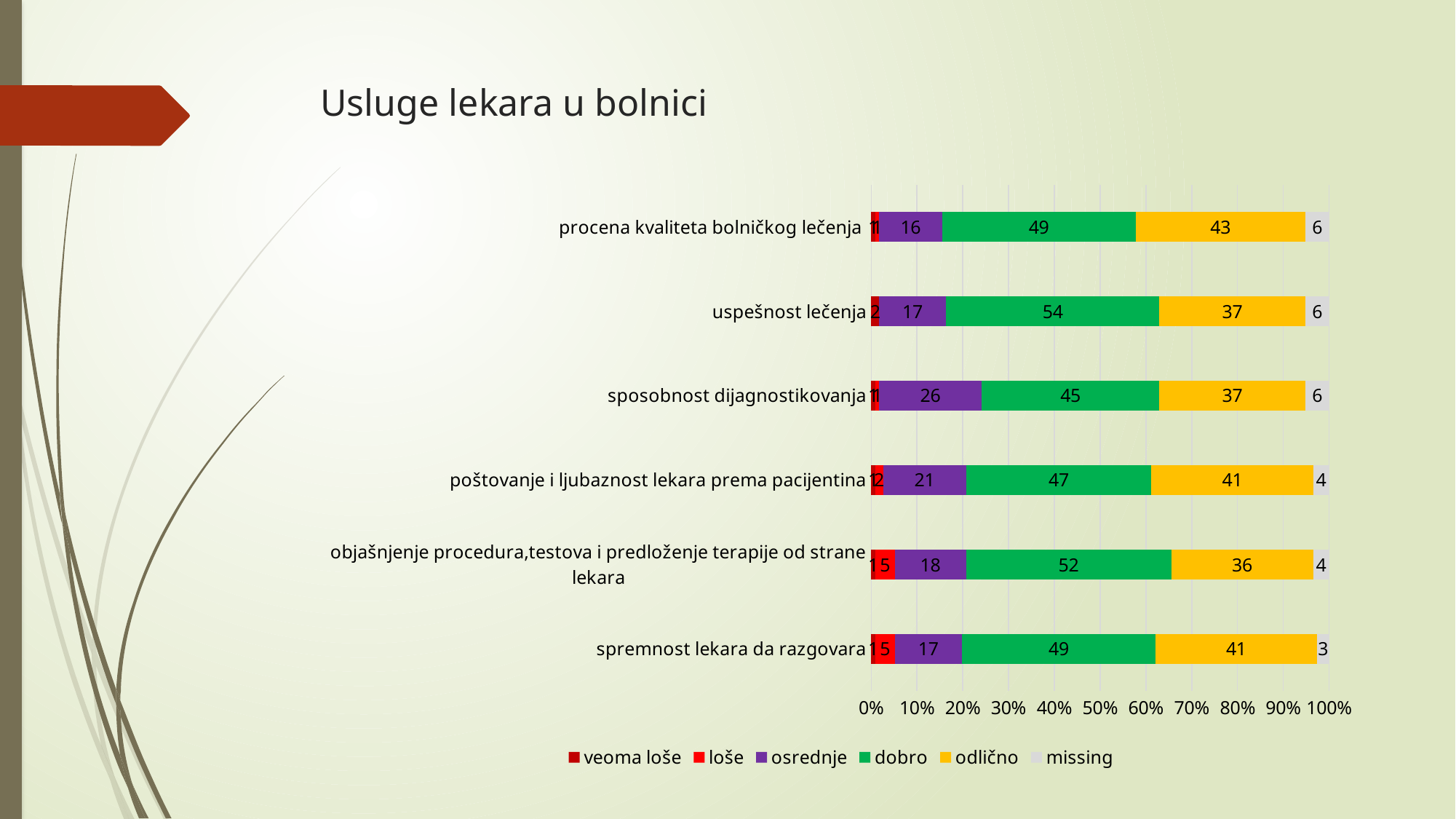
What is the title of the slide? Usluge lekara u bolnici What is the 'dobro' value for 'uspešnost lečenja'? 54 How many series does the legend list? 6 What kind of chart is shown on the slide? Stacked bar chart Which category has the highest 'osrednje' value? sposobnost dijagnostikovanja What is the 'odlično' value for 'procena kvaliteta bolničkog lečenja'? 43 Which category has the highest 'dobro' value? uspešnost lečenja Which has the larger 'odlično' value: 'procena kvaliteta bolničkog lečenja' or 'poštovanje i ljubaznost lekara prema pacijentina'? procena kvaliteta bolničkog lečenja How many categories are plotted on the chart? 6 Which category has the lowest 'missing' value? spremnost lekara da razgovara What is the 'osrednje' value for 'sposobnost dijagnostikovanja'? 26 What is the difference between the 'osrednje' value for 'sposobnost dijagnostikovanja' and the 'osrednje' value for 'procena kvaliteta bolničkog lečenja'? 10